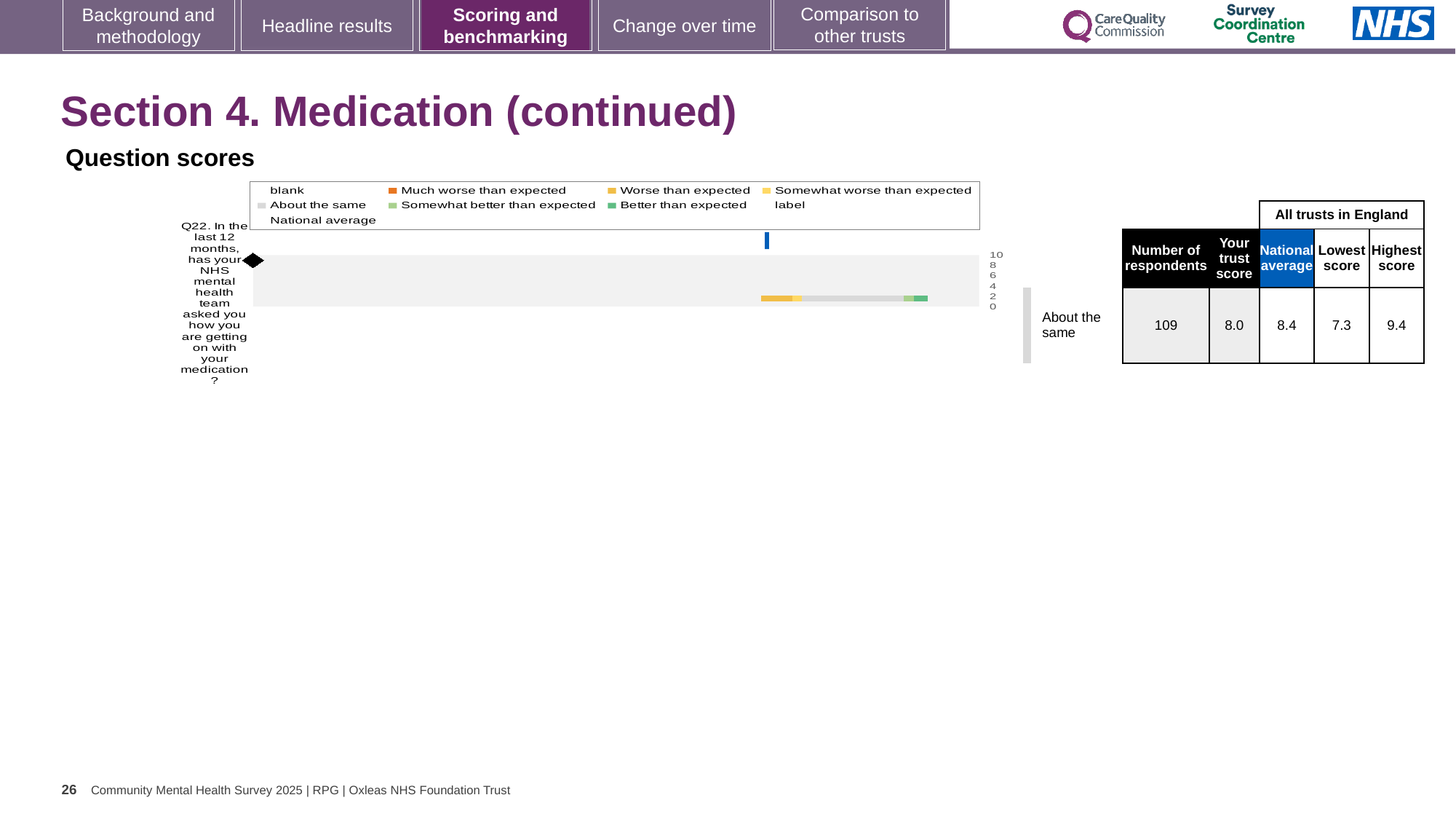
What is the difference between the highest and lowest scores among all trusts in England for Q22? 2.1 Which is larger for Q22, the trust's score or the national average? national average Which question is plotted in the chart? Q22. In the last 12 months, has your NHS mental health team asked you how you are getting on with your medication? What is the maximum value shown on the chart's score axis? 10 What is the benchmark category shown for Q22? About the same What is the trust's score for Q22? 8.0 How many questions (categories) are plotted in the chart? 1 What is the highest score among all trusts in England for Q22? 9.4 What kind of chart is shown on the slide? bar chart What is the national average score for Q22? 8.4 How many respondents answered Q22? 109 What is the lowest score among all trusts in England for Q22? 7.3